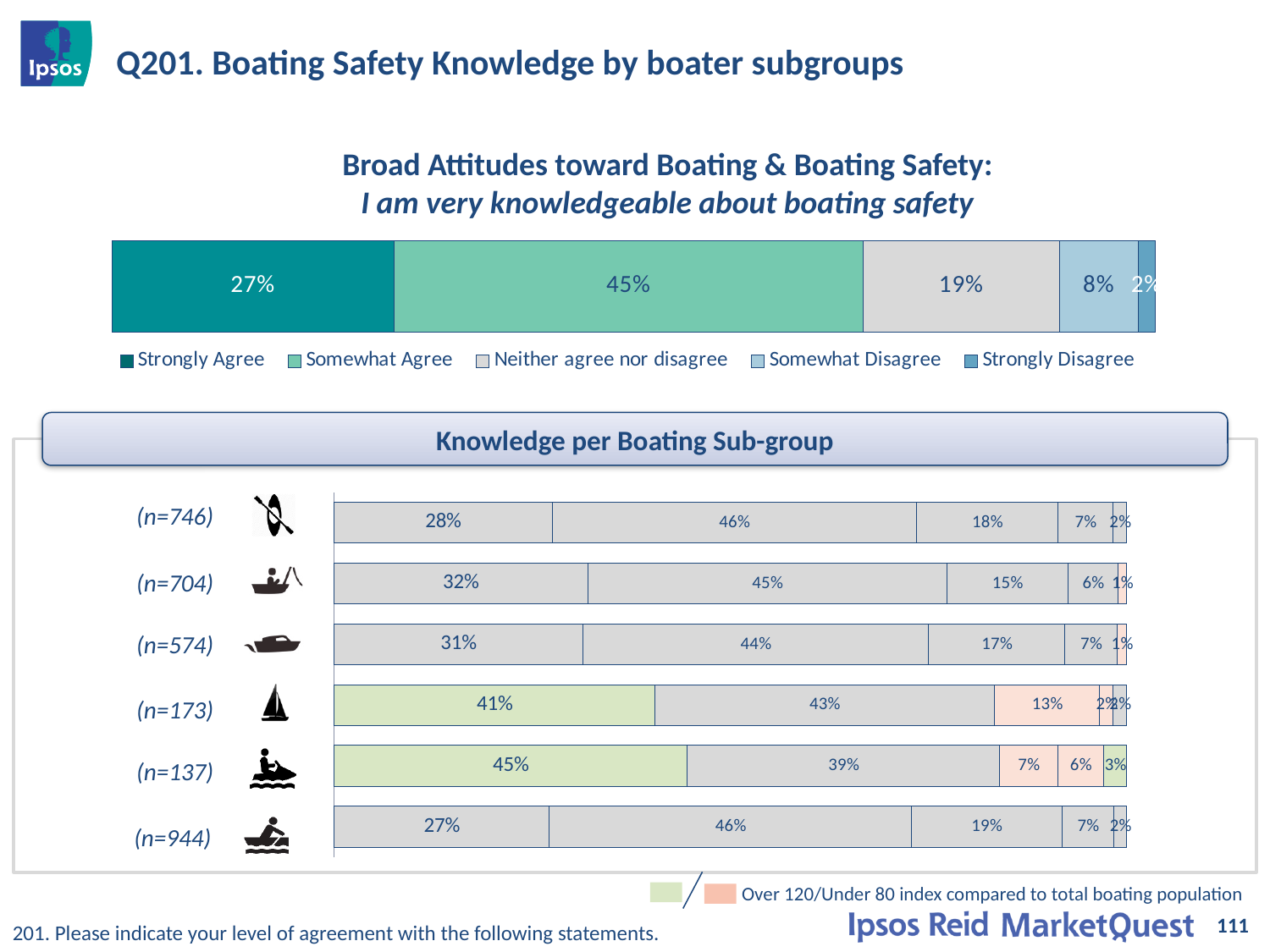
What type of chart is used in the 'Knowledge per Boating Sub-group' section? Stacked horizontal bar chart In the 'Knowledge per Boating Sub-group' chart, which sub-group has the lowest first-segment (Strongly Agree) value? (n=944) In the 'Knowledge per Boating Sub-group' chart, what is the difference between the first-segment values of the (n=173) and (n=746) sub-groups? 13 percentage points In the 'Knowledge per Boating Sub-group' chart, what is the first (Strongly Agree) value for the (n=137) sub-group? 45% In the 'Knowledge per Boating Sub-group' chart, what is the second (Somewhat Agree) value for the (n=704) sub-group? 45% In the top chart 'I am very knowledgeable about boating safety', which response category has the largest share? Somewhat Agree In the 'Knowledge per Boating Sub-group' chart, how many boating sub-groups are shown? 6 In the top chart 'I am very knowledgeable about boating safety', how many response categories does the legend list? 5 In the top chart 'I am very knowledgeable about boating safety', what percentage Somewhat Disagree? 8% In the top chart 'I am very knowledgeable about boating safety', what is the combined percentage of Strongly Agree and Somewhat Agree? 72% In the top chart 'I am very knowledgeable about boating safety', what percentage of respondents Strongly Agree? 27% In the 'Knowledge per Boating Sub-group' chart, which sub-group has the highest first-segment (Strongly Agree) value? (n=137)